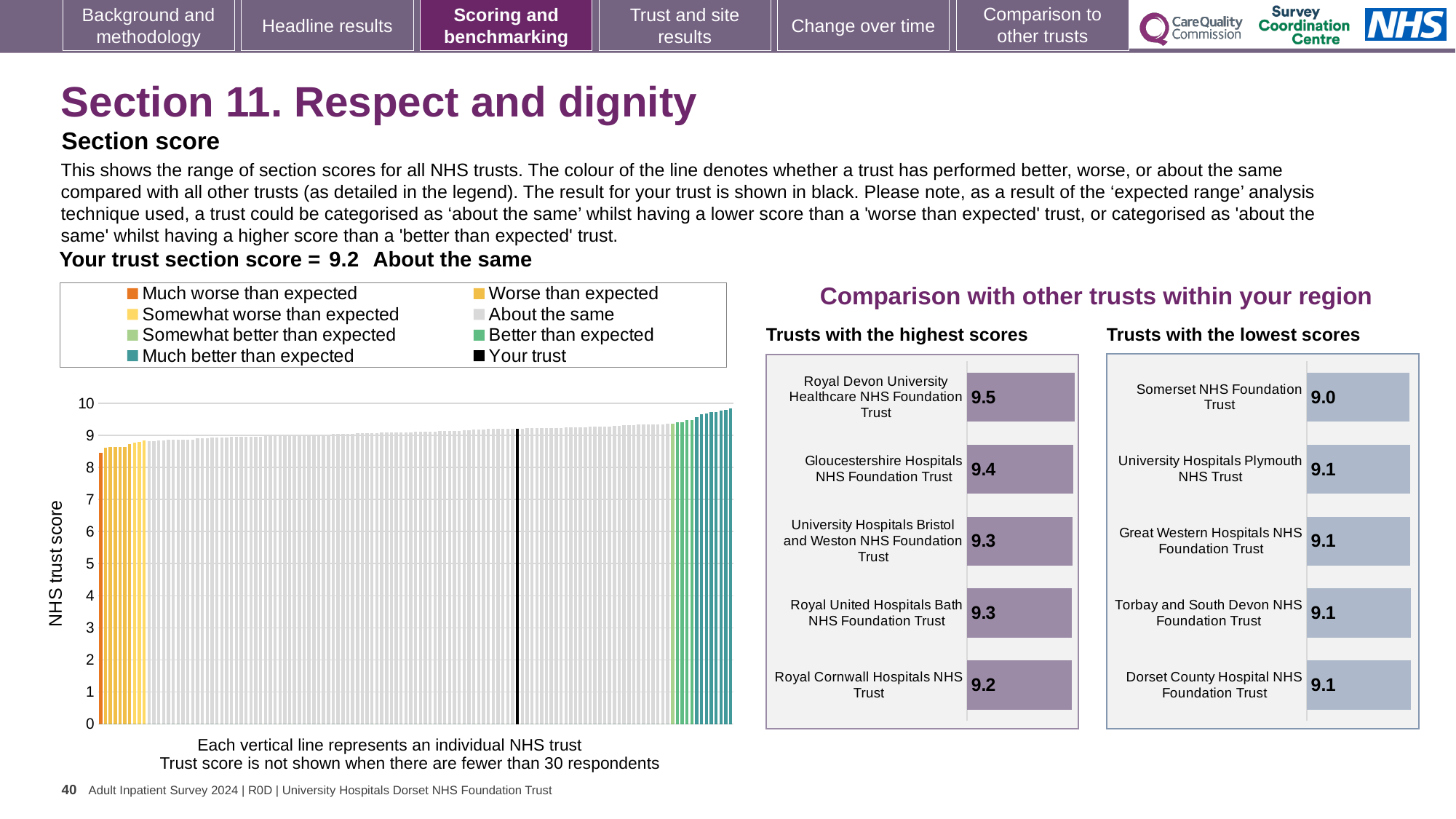
In the 'Trusts with the highest scores' chart, what is the score for Royal Cornwall Hospitals NHS Trust? 9.2 In the 'Trusts with the lowest scores' chart, what is the difference between the scores of Dorset County Hospital NHS Foundation Trust and Somerset NHS Foundation Trust? 0.1 In the 'Trusts with the highest scores' chart, which trust has the highest score? Royal Devon University Healthcare NHS Foundation Trust In the main 'NHS trust score' chart on the left, what is the section score for your trust? 9.2 In the 'Trusts with the highest scores' chart, what is the score for Royal Devon University Healthcare NHS Foundation Trust? 9.5 How many entries does the legend of the main 'NHS trust score' chart list? 8 In the 'Trusts with the lowest scores' chart, what is the score for Somerset NHS Foundation Trust? 9.0 In the 'Trusts with the highest scores' chart, what is the difference between the scores of Royal Devon University Healthcare NHS Foundation Trust and Royal Cornwall Hospitals NHS Trust? 0.3 How many trusts are shown in the 'Trusts with the lowest scores' chart? 5 In the 'Trusts with the lowest scores' chart, which trust has the lowest score? Somerset NHS Foundation Trust What kind of chart is the main 'NHS trust score' chart on the left? Bar chart In the 'Trusts with the highest scores' chart, which has the larger score: Gloucestershire Hospitals NHS Foundation Trust or Royal Cornwall Hospitals NHS Trust? Gloucestershire Hospitals NHS Foundation Trust